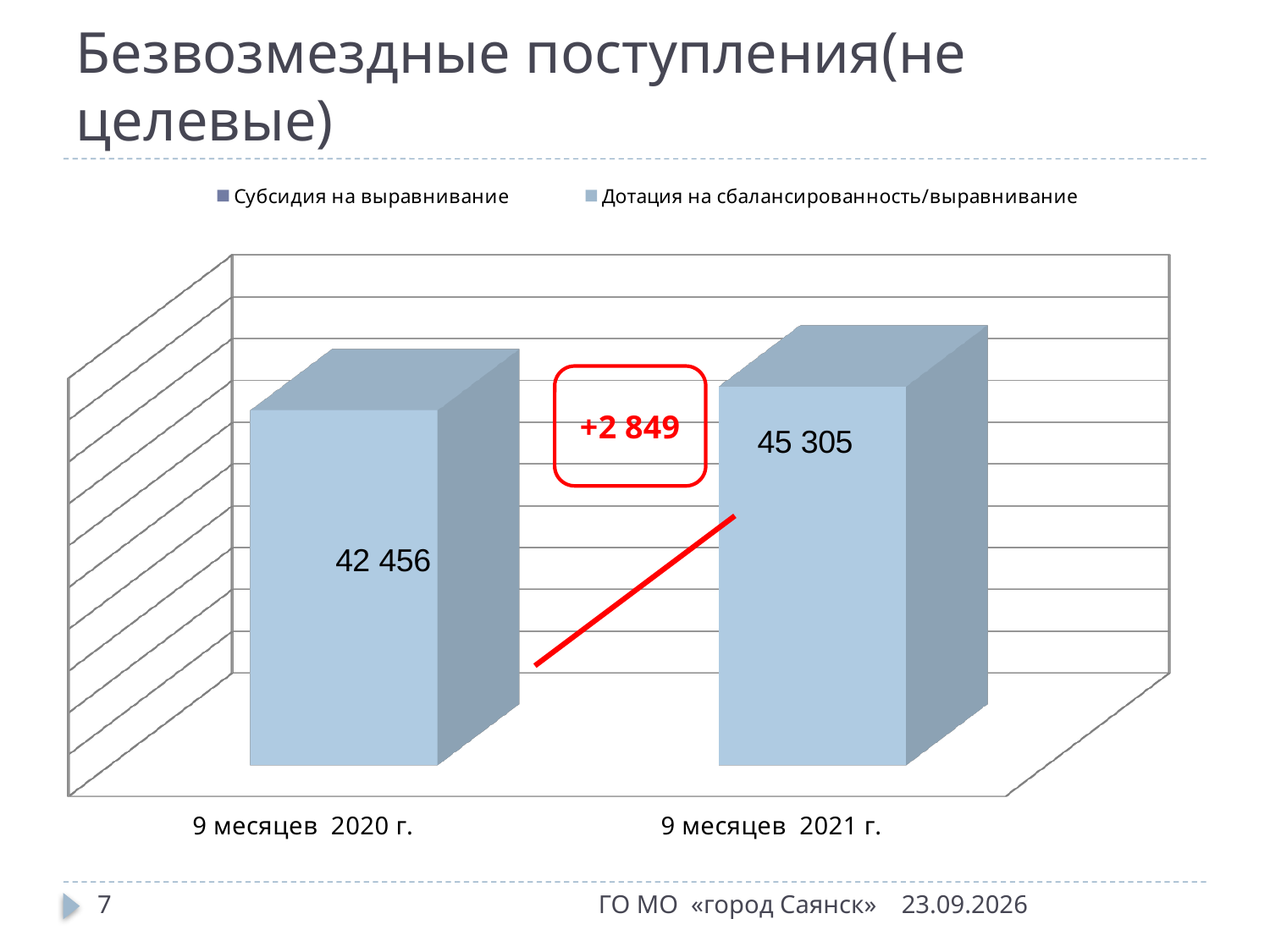
How many series does the legend list? 2 What kind of chart is shown on the slide? Bar chart What is the value for 9 месяцев 2021 г.? 45 305 What is the value for 9 месяцев 2020 г.? 42 456 Which category has the lowest value? 9 месяцев 2020 г. Do the values rise or fall from 9 месяцев 2020 г. to 9 месяцев 2021 г.? Rise Which is larger, the value for 9 месяцев 2020 г. or for 9 месяцев 2021 г.? 9 месяцев 2021 г. Which category has the highest value? 9 месяцев 2021 г. What is the title of the slide? Безвозмездные поступления(не целевые) What change is shown in the red box between the two bars? +2 849 How many categories are shown on the x axis? 2 What is the difference between the values for 9 месяцев 2021 г. and 9 месяцев 2020 г.? 2 849